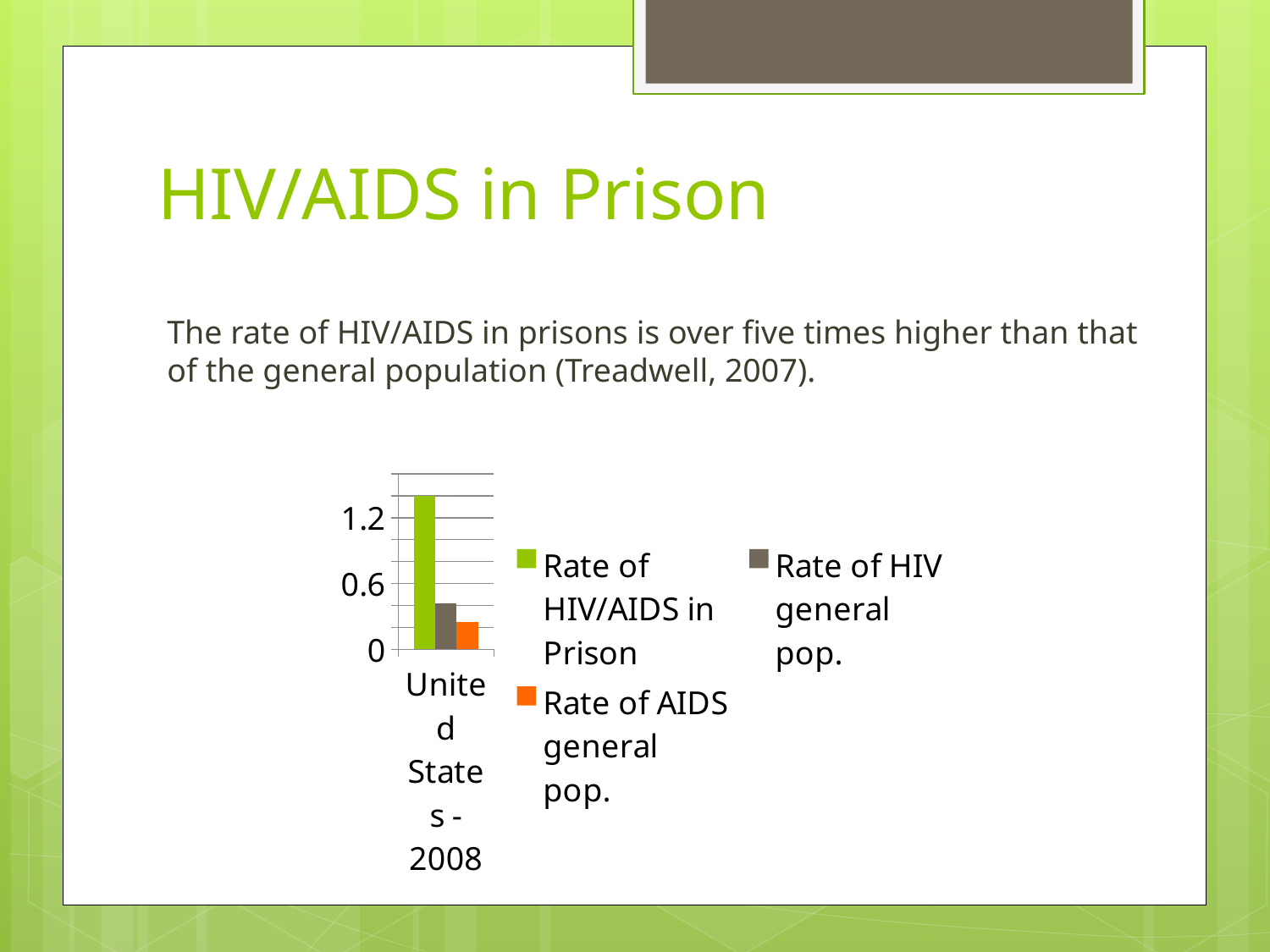
Which is larger, the Rate of HIV general pop. or the Rate of AIDS general pop.? Rate of HIV general pop. Is the value for Rate of HIV/AIDS in Prison greater or less than 1.2? greater What is the category label shown on the x axis of the chart? United States - 2008 How many categories are shown on the x axis of the chart? 1 What kind of chart is shown on the slide? bar chart Is the value for Rate of HIV general pop. greater or less than 0.6? less Which is larger, the Rate of HIV/AIDS in Prison or the Rate of HIV general pop.? Rate of HIV/AIDS in Prison How many series does the chart's legend list? 3 What colour represents the Rate of HIV/AIDS in Prison series in the chart? green Which series has the lowest value in the chart? Rate of AIDS general pop. Is the value for Rate of AIDS general pop. greater or less than 0.6? less Which series has the highest value in the chart? Rate of HIV/AIDS in Prison